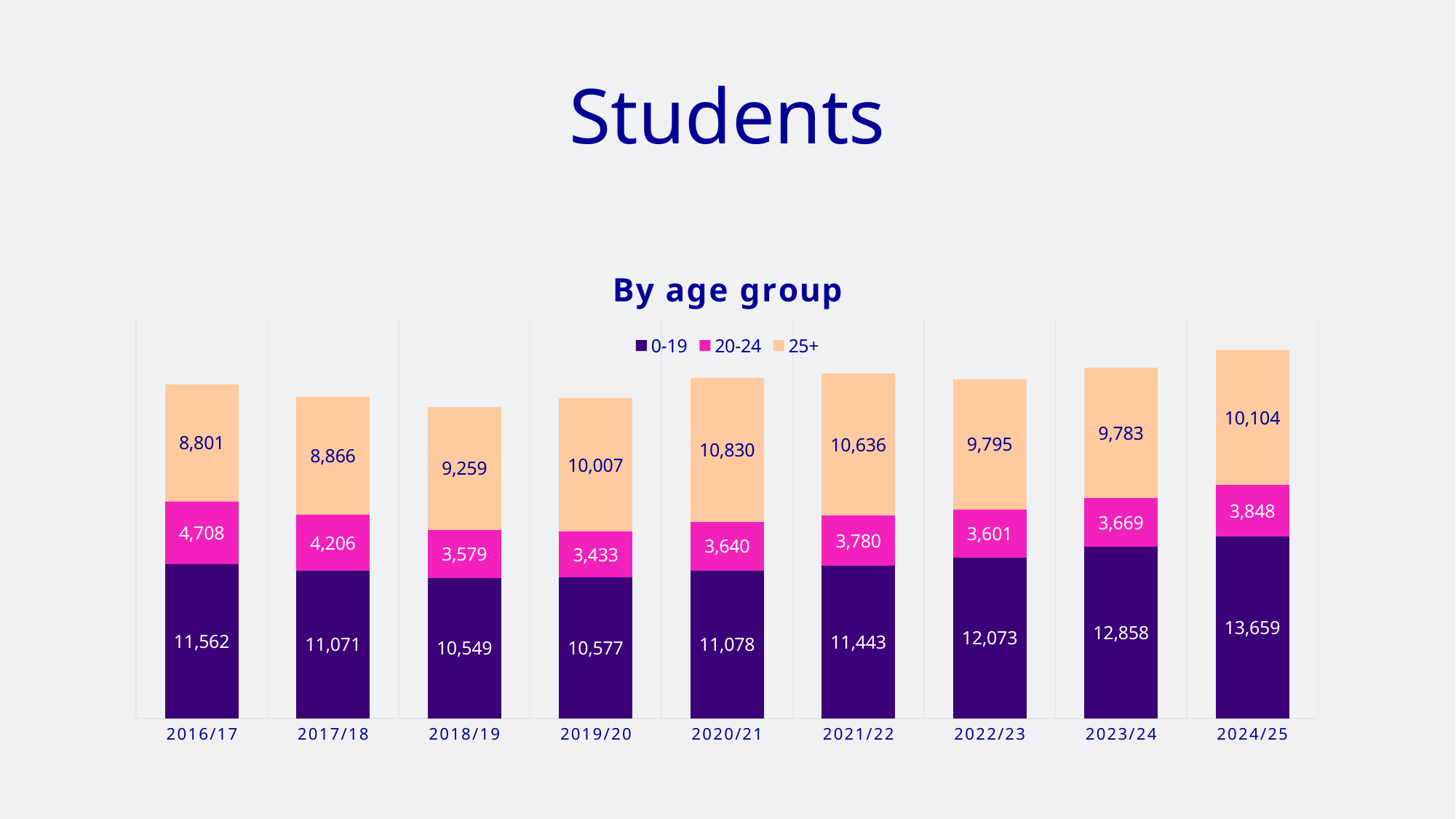
What kind of chart is shown on the slide? Stacked bar chart What is the difference between the 0-19 values for 2024/25 and 2016/17? 2,097 What is the value for the 20-24 age group in 2017/18? 4,206 How many years are shown on the x axis? 9 How many series does the legend list? 3 What is the value for the 25+ age group in 2020/21? 10,830 In which year is the 0-19 age group value the highest? 2024/25 In which year is the 25+ age group value the highest? 2020/21 Which is larger: the 20-24 value in 2016/17 or in 2024/25? 2016/17 What is the value for the 0-19 age group in 2024/25? 13,659 What is the total of the stacked bar for 2016/17? 25,071 In which year is the 20-24 age group value the lowest? 2019/20